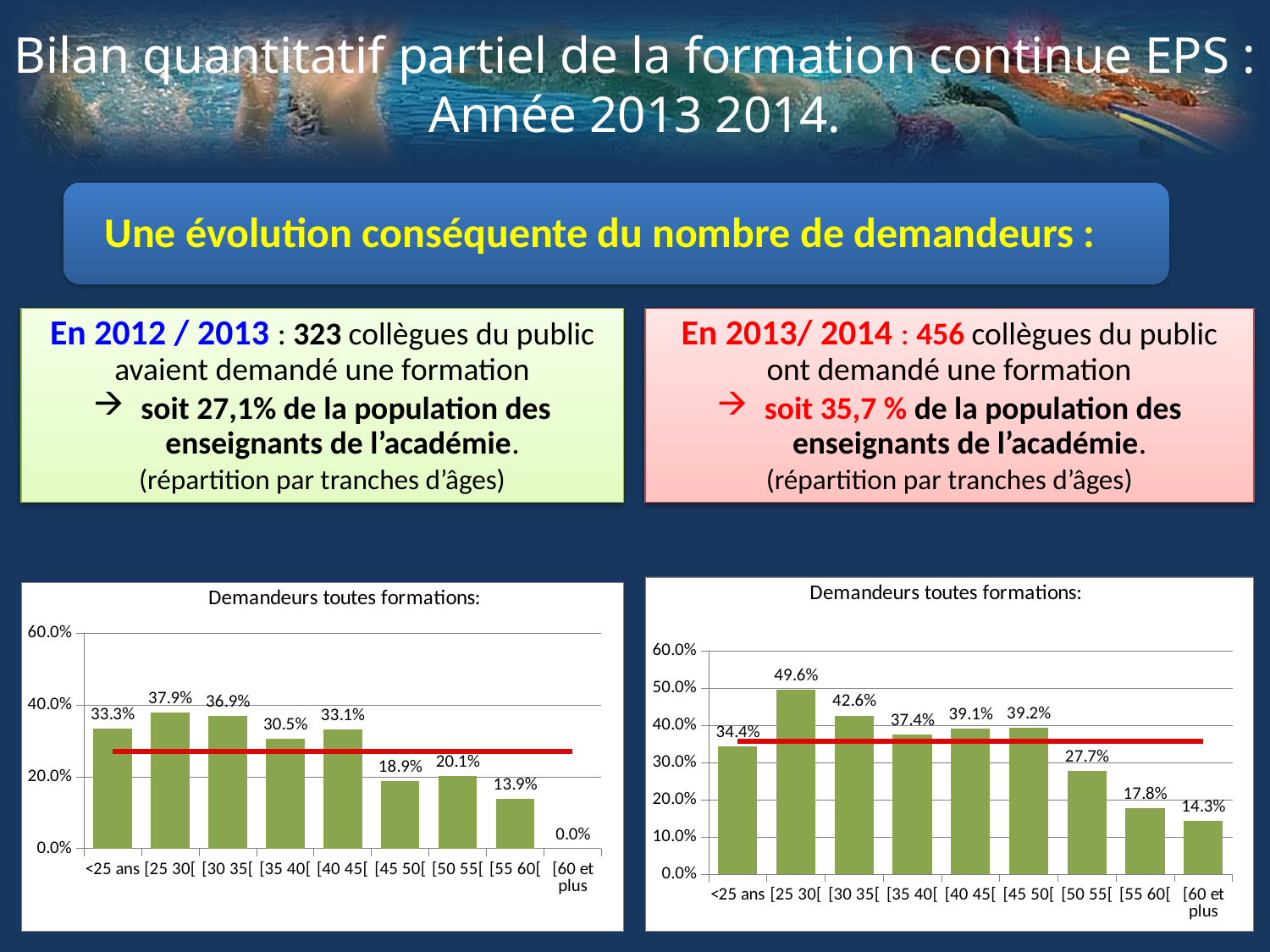
In the left chart (2012/2013), which is larger: the value for [35 40[ or the value for [40 45[? [40 45[ In the right chart (2013/2014), which age group has the lowest value? [60 et plus In the left chart (2012/2013), what is the difference between the values for [25 30[ and [55 60[? 24.0% In the right chart (Demandeurs toutes formations, 2013/2014), what is the value for the [50 55[ age group? 27.7% In the left chart (Demandeurs toutes formations, 2012/2013), what is the value for the [25 30[ age group? 37.9% How many age groups are shown on the x axis of the left chart (2012/2013)? 9 In the right chart (2013/2014), which age group has the highest value? [25 30[ In the right chart (2013/2014), is the value for [30 35[ greater or less than 40.0%? greater What type of chart is the right chart (Demandeurs toutes formations, 2013/2014)? Combination bar and line chart In the left chart (2012/2013), which age group has the lowest value? [60 et plus In the right chart (2013/2014), what is the difference between the values for [25 30[ and <25 ans? 15.2% What is the title of the left chart? Demandeurs toutes formations: